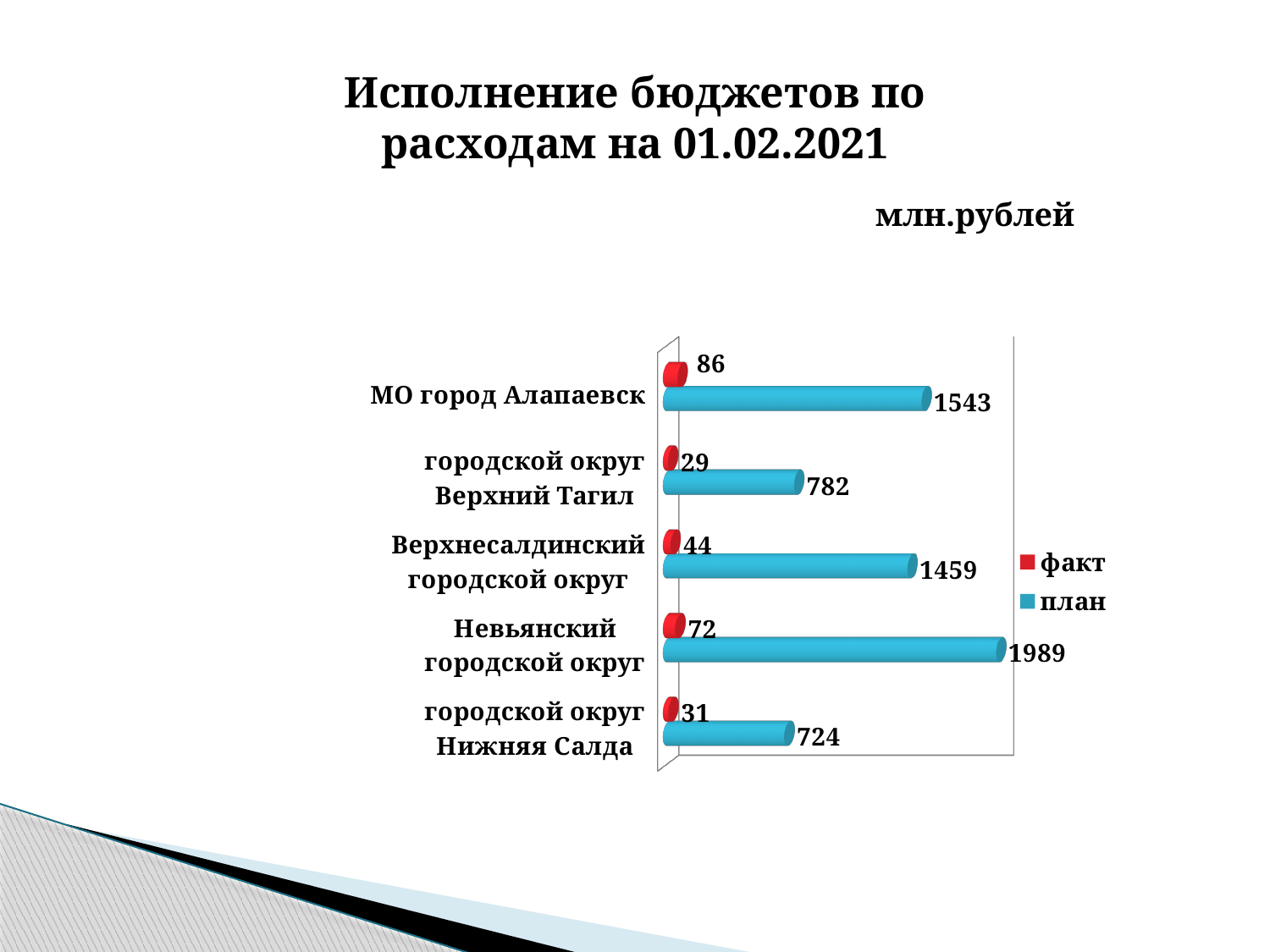
Which category has the highest план value? Невьянский городской округ What kind of chart is shown on the slide? bar chart How many series does the legend list? 2 Which category has the lowest факт value? городской округ Верхний Тагил What is the difference between the план and факт values for Верхнесалдинский городской округ? 1415 Which is larger, the план value for городской округ Верхний Тагил or for городской округ Нижняя Салда? городской округ Верхний Тагил What is the факт value for городской округ Верхний Тагил? 29 What colour are the факт bars? red What is the факт value for Невьянский городской округ? 72 What is the план value for МО город Алапаевск? 1543 What is the план value for городской округ Нижняя Салда? 724 How many categories are shown on the chart? 5